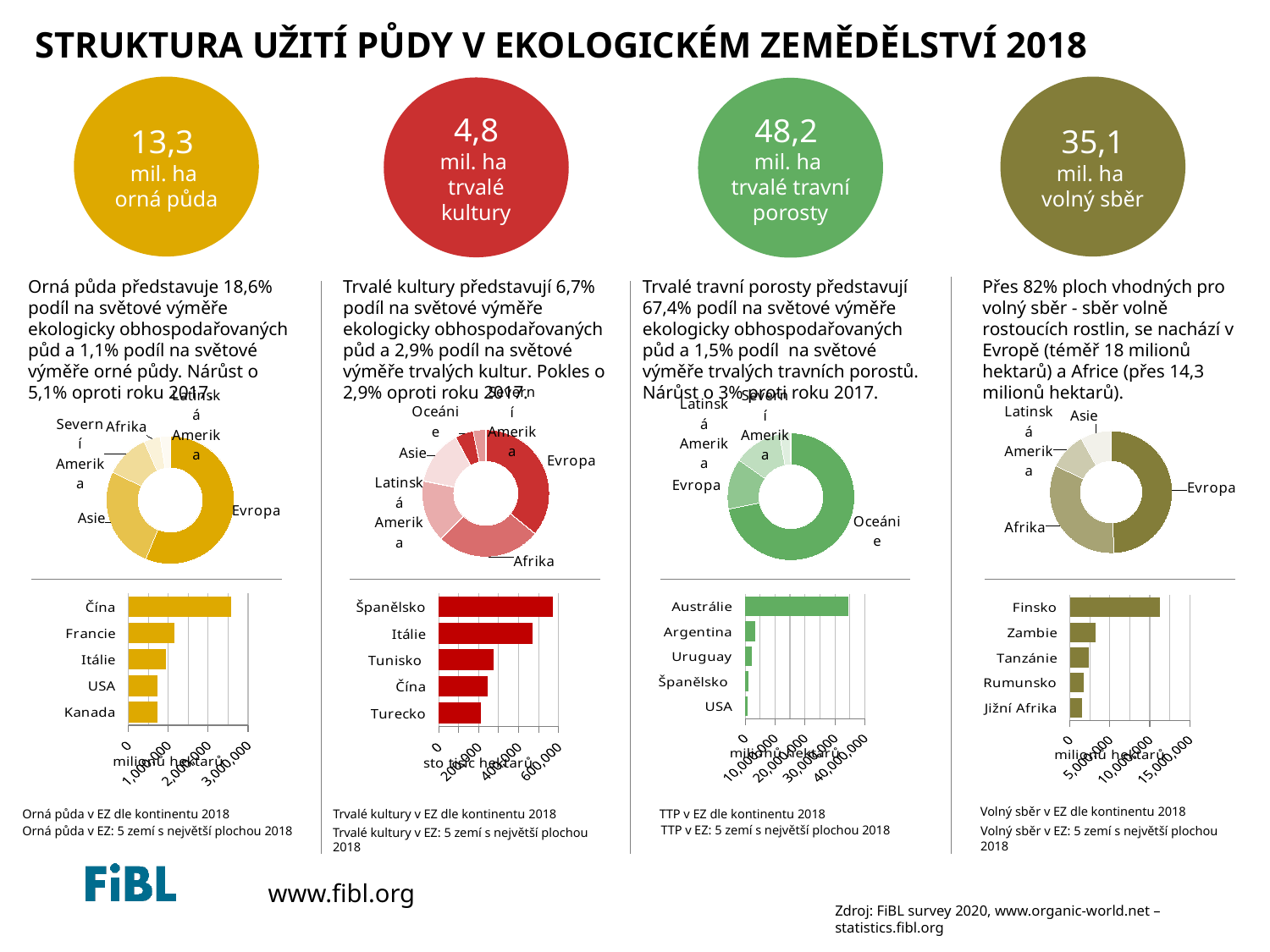
In the chart 'Trvalé kultury v EZ: 5 zemí s největší plochou 2018', is the value for Španělsko greater or less than 400,000? greater What kind of chart is 'Trvalé kultury v EZ dle kontinentu 2018'? Pie (donut) chart In the chart 'TTP v EZ: 5 zemí s největší plochou 2018', which is larger, Austrálie or Argentina? Austrálie In the chart 'Trvalé kultury v EZ: 5 zemí s největší plochou 2018', which country has the largest area? Španělsko In the chart 'TTP v EZ dle kontinentu 2018', which continent has the largest share? Oceánie In the chart 'Volný sběr v EZ: 5 zemí s největší plochou 2018', which country has the largest area? Finsko In the chart 'Orná půda v EZ: 5 zemí s největší plochou 2018', is the value for Čína greater or less than 2,000,000? greater How many countries are shown in the chart 'Orná půda v EZ: 5 zemí s největší plochou 2018'? 5 What kind of chart is 'Volný sběr v EZ: 5 zemí s největší plochou 2018'? Bar chart In the chart 'TTP v EZ: 5 zemí s největší plochou 2018', is the value for Austrálie greater or less than 30,000,000? greater